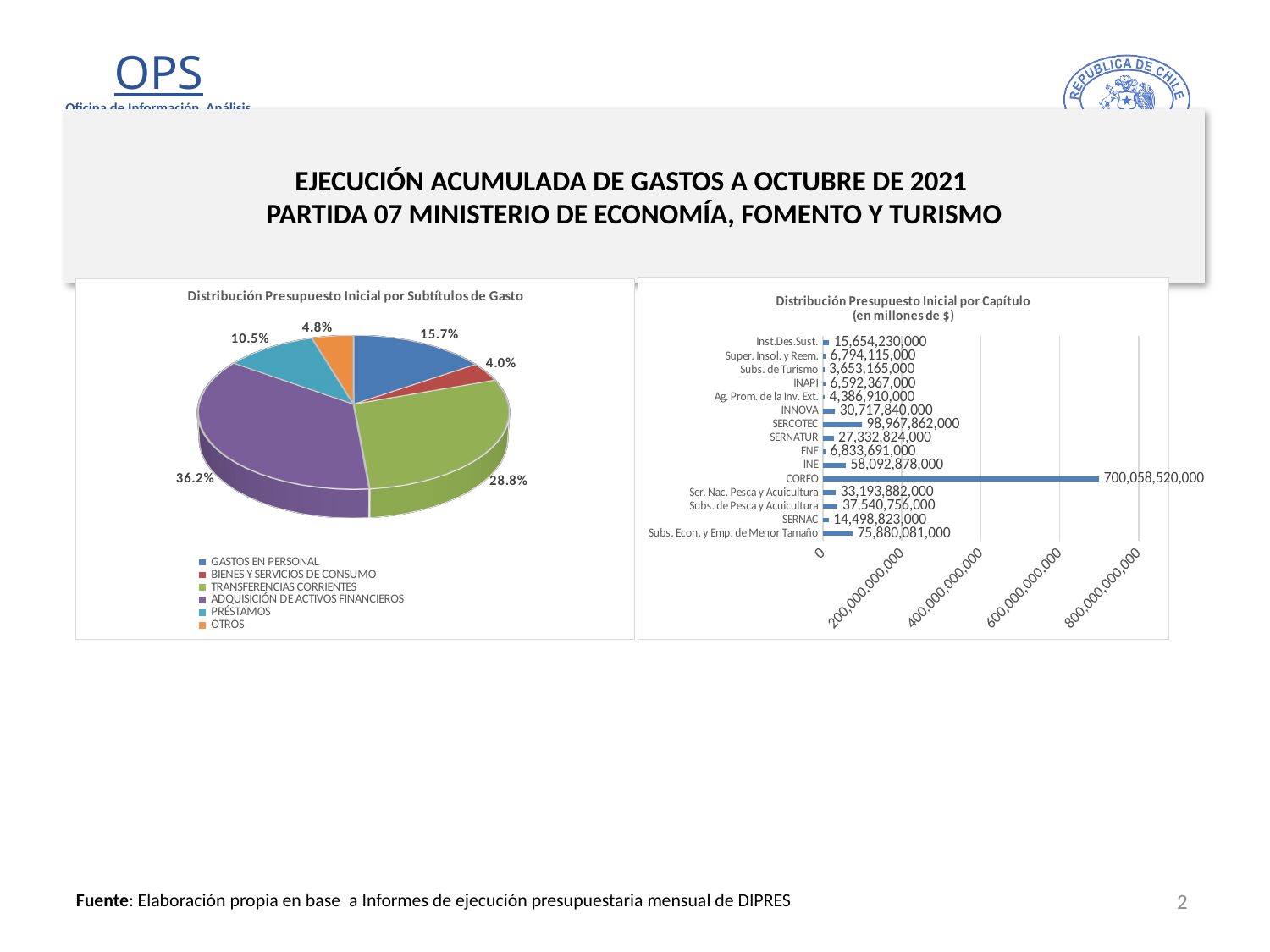
In the chart 'Distribución Presupuesto Inicial por Capítulo', which capítulo has the lowest value? Subs. de Turismo In the chart 'Distribución Presupuesto Inicial por Capítulo', what is the value for CORFO? 700,058,520,000 What kind of chart is 'Distribución Presupuesto Inicial por Capítulo'? Bar chart In the chart 'Distribución Presupuesto Inicial por Subtítulos de Gasto', what share does ADQUISICIÓN DE ACTIVOS FINANCIEROS have? 36.2% What kind of chart is 'Distribución Presupuesto Inicial por Subtítulos de Gasto'? Pie chart In the chart 'Distribución Presupuesto Inicial por Capítulo', what is the value for SERCOTEC? 98,967,862,000 How many categories does the legend of the chart 'Distribución Presupuesto Inicial por Subtítulos de Gasto' list? 6 In the chart 'Distribución Presupuesto Inicial por Subtítulos de Gasto', which category has the largest share? ADQUISICIÓN DE ACTIVOS FINANCIEROS In the chart 'Distribución Presupuesto Inicial por Capítulo', which is larger, the value for INE or the value for SERNATUR? INE In the chart 'Distribución Presupuesto Inicial por Subtítulos de Gasto', which category has the smallest share? BIENES Y SERVICIOS DE CONSUMO In the chart 'Distribución Presupuesto Inicial por Subtítulos de Gasto', what share does GASTOS EN PERSONAL have? 15.7% In the chart 'Distribución Presupuesto Inicial por Capítulo', which capítulo has the highest value? CORFO